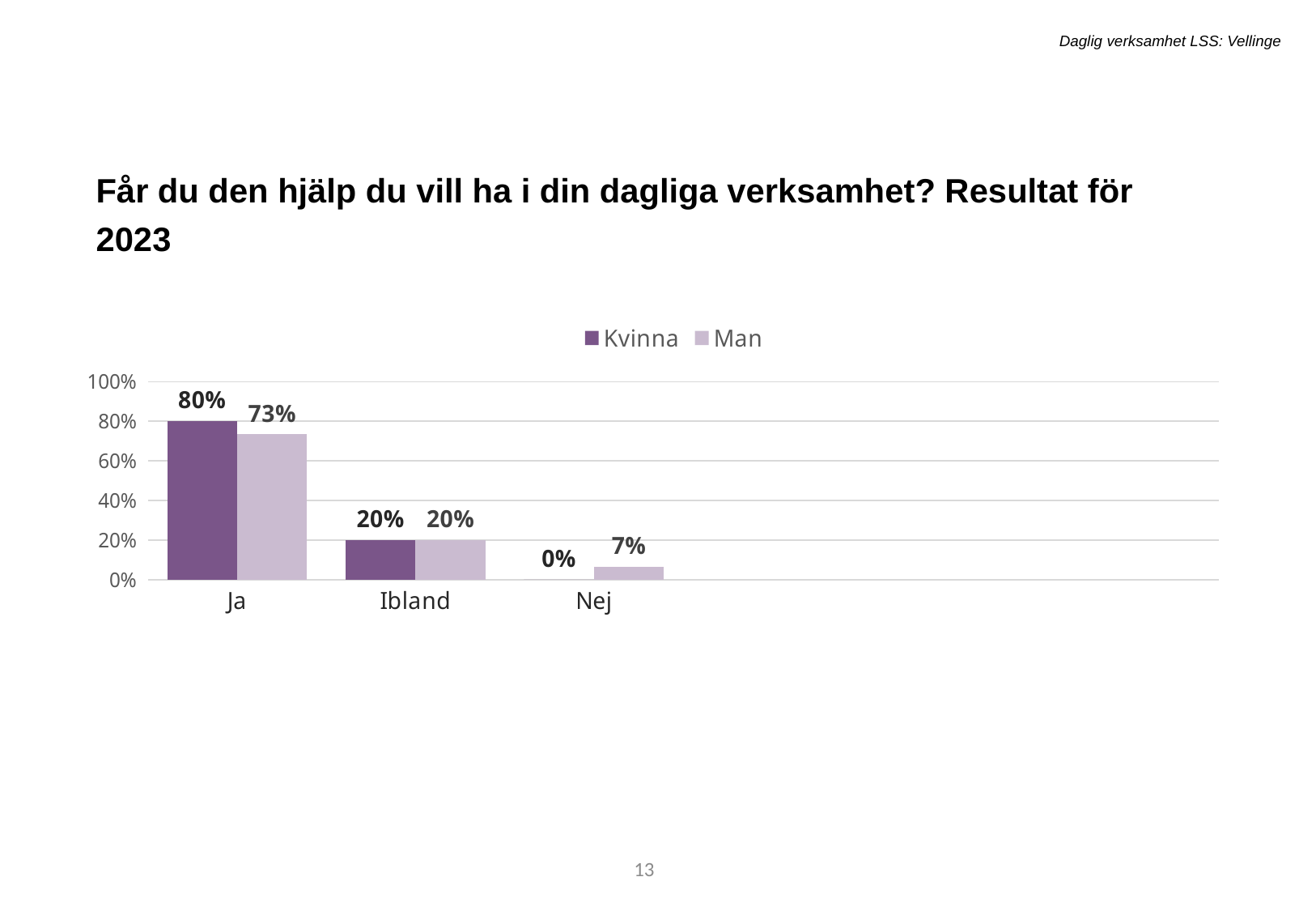
What is the value for Man in the Nej category? 7% What kind of chart is shown on the slide? Bar chart Do the Man values rise or fall from Ja to Nej along the x axis? Fall Which category has the lowest value for the Man series? Nej How many categories are shown on the x axis? 3 What is the value for Kvinna in the Ja category? 80% How many series does the legend list? 2 Which category has the highest value for the Kvinna series? Ja Which is larger in the Nej category, the Kvinna value or the Man value? Man What is the value for Man in the Ja category? 73% What is the difference between the Kvinna and Man values in the Ja category? 7% What is the value for Kvinna in the Nej category? 0%